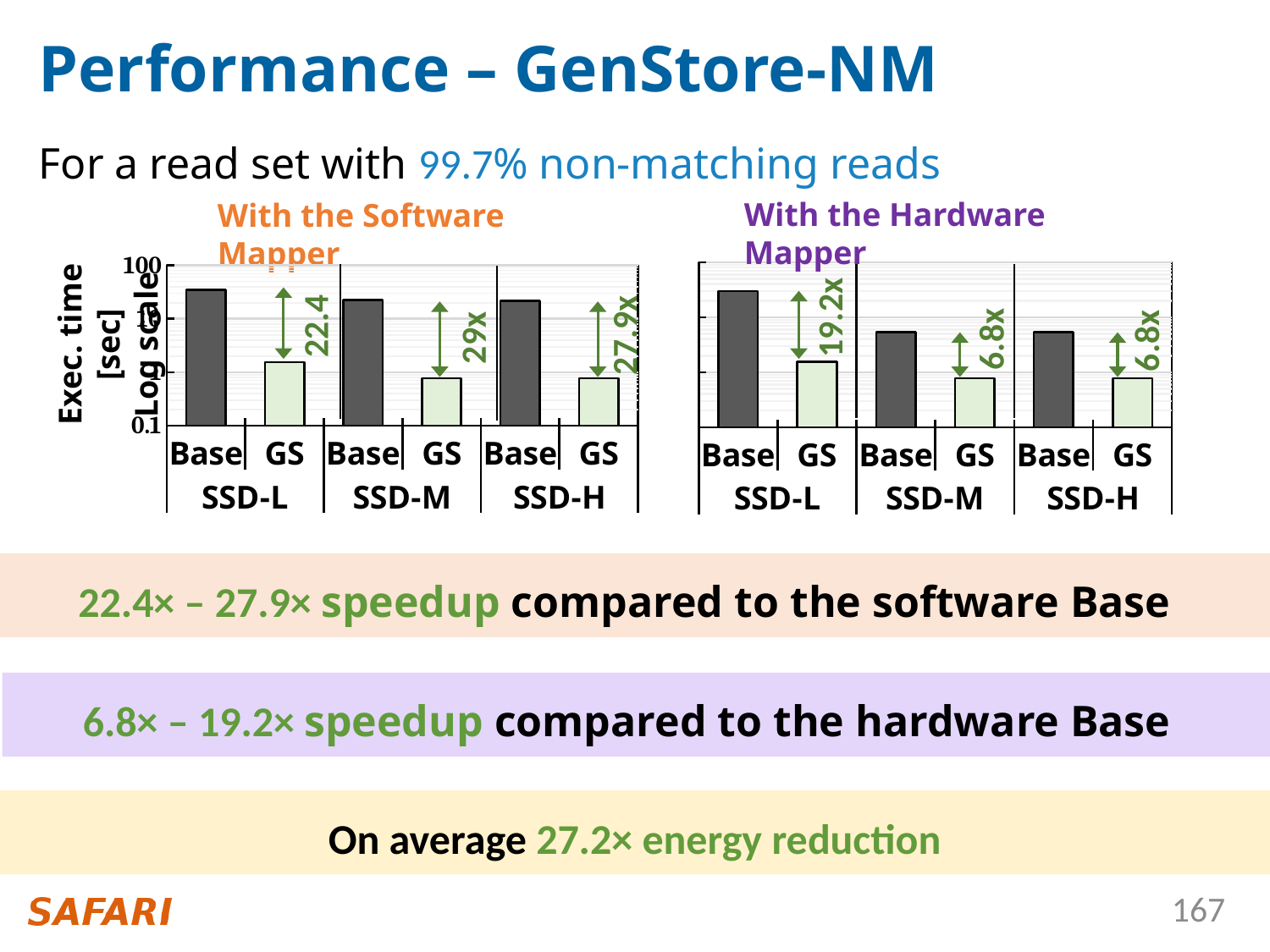
In the 'With the Hardware Mapper' chart, what speedup is annotated for SSD-M? 6.8x In the 'With the Software Mapper' chart, which SSD configuration has the highest annotated speedup? SSD-M In the 'With the Hardware Mapper' chart, what speedup is annotated for SSD-L? 19.2x In the 'With the Software Mapper' chart, is the Base execution time for SSD-L greater or less than 10? greater In the 'With the Software Mapper' chart, how many SSD configurations are shown on the x axis? 3 In the 'With the Hardware Mapper' chart, which SSD configuration has the highest annotated speedup? SSD-L What kind of chart is the 'With the Software Mapper' chart? bar chart In the 'With the Software Mapper' chart, which SSD configuration has the lowest annotated speedup? SSD-L In the 'With the Software Mapper' chart, for SSD-L, which bar is taller: Base or GS? Base In the 'With the Software Mapper' chart, what speedup is annotated for SSD-M? 29x In the 'With the Software Mapper' chart, what speedup is annotated for SSD-H? 27.9x What is the y-axis label of the charts? Exec. time [sec] Log scale